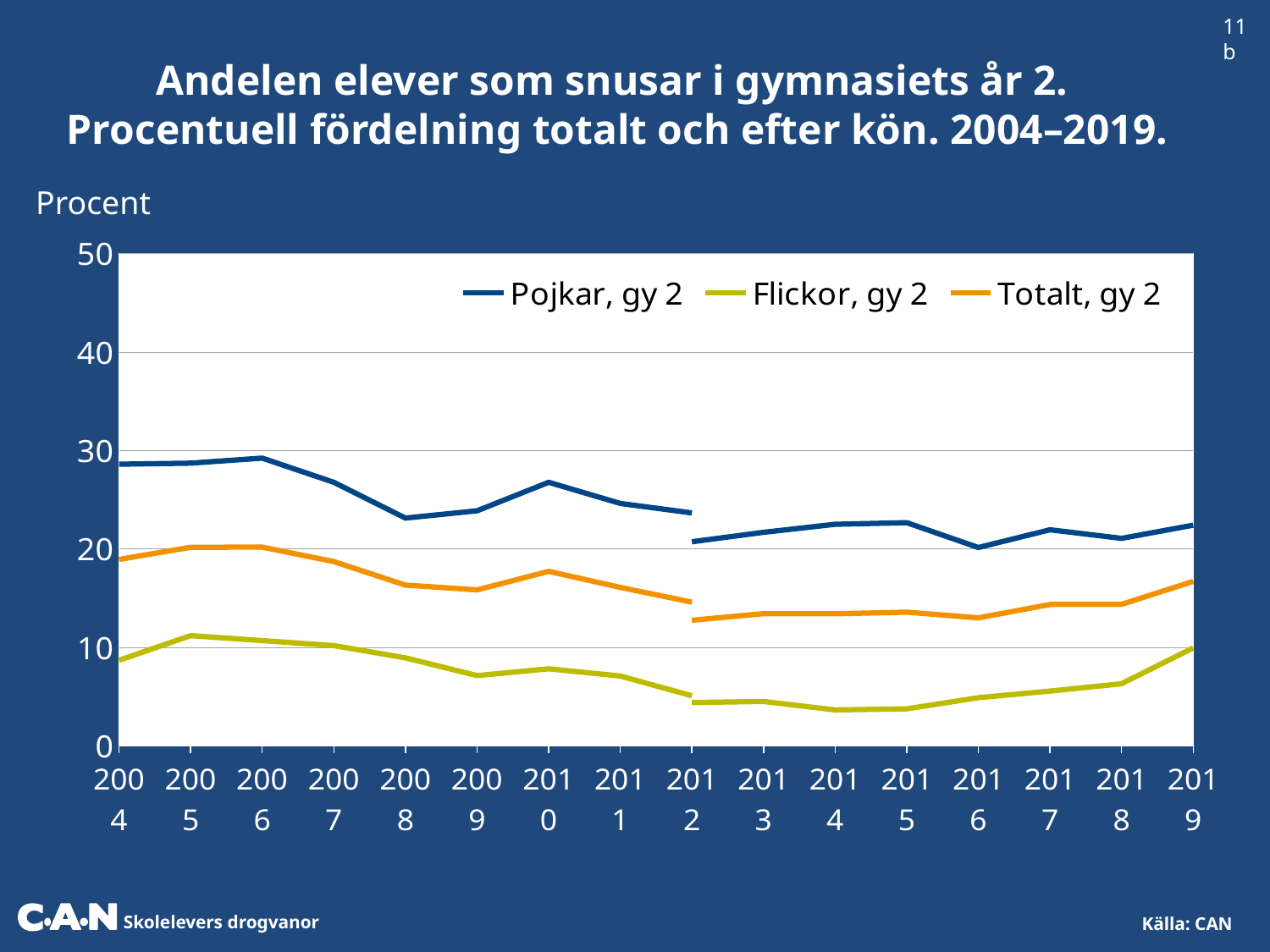
Is the value for Flickor, gy 2 in 2014 greater or less than 10? less Is the value for Pojkar, gy 2 in 2016 greater or less than 30? less Which series has the lowest values throughout the period? Flickor, gy 2 What is the label on the y axis? Procent What kind of chart is shown on the slide? line chart In 2010, which is larger: the value for Pojkar, gy 2 or Flickor, gy 2? Pojkar, gy 2 How many series does the legend list? 3 Which series has the highest values throughout the period? Pojkar, gy 2 Do the values for Flickor, gy 2 rise or fall from 2005 to 2014? fall Is the value for Totalt, gy 2 in 2008 greater or less than 20? less How many years are shown on the x axis? 16